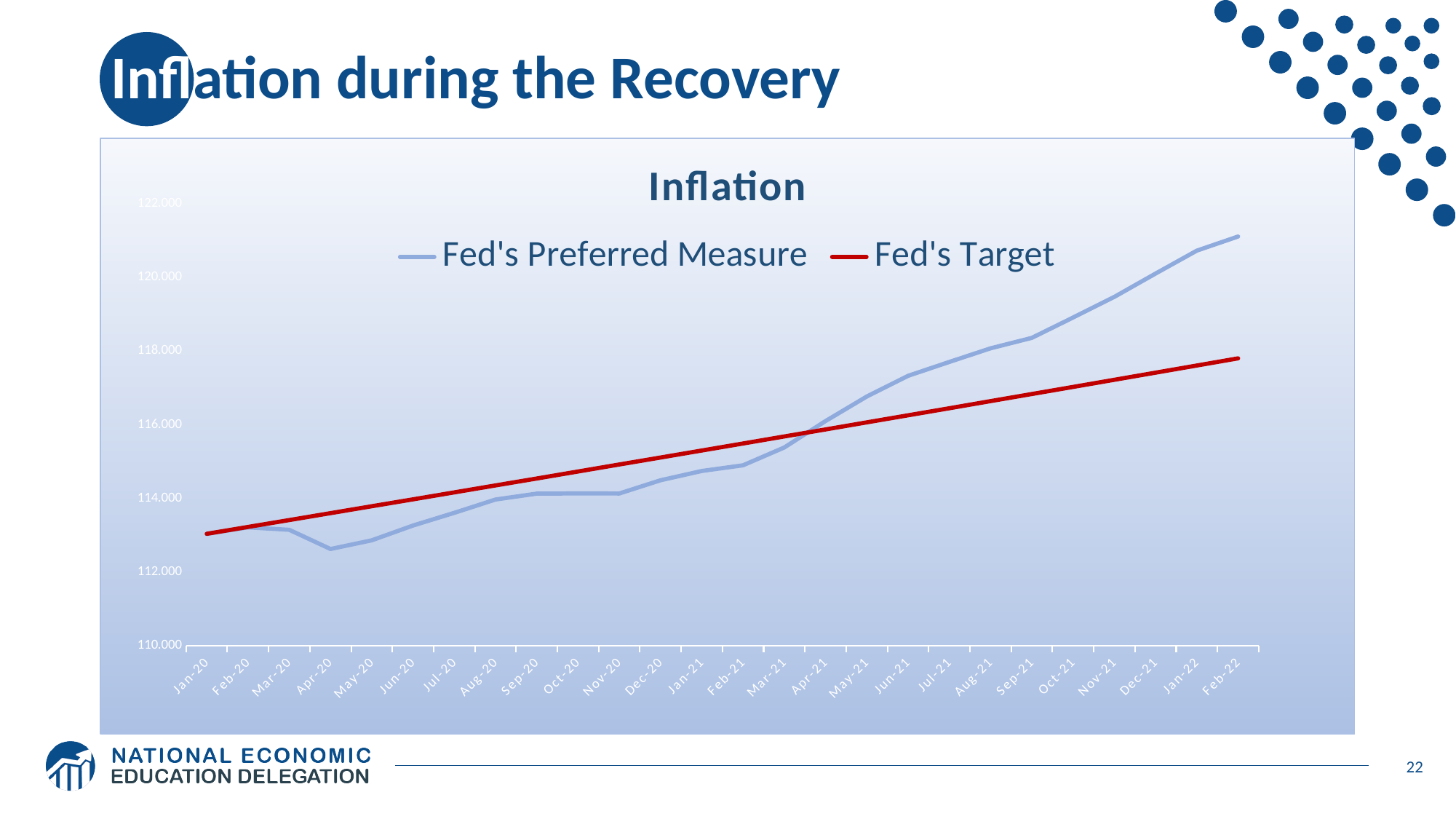
Is the value of Fed's Preferred Measure in Apr-20 greater or less than 114.000? less At which month does the Fed's Preferred Measure reach its lowest value? Apr-20 In Feb-22, which is larger: Fed's Preferred Measure or Fed's Target? Fed's Preferred Measure How many series does the legend of the Inflation chart list? 2 In Apr-20, which is larger: Fed's Preferred Measure or Fed's Target? Fed's Target What is the title of the chart? Inflation How many monthly points are plotted along the x axis of the Inflation chart? 26 What kind of chart is shown on the slide? line chart Does the Fed's Target line rise or fall from Jan-20 to Feb-22? rise Which series is drawn in red in the Inflation chart? Fed's Target Is the value of Fed's Preferred Measure in Feb-22 greater or less than 120.000? greater At which month does the Fed's Preferred Measure reach its highest value? Feb-22